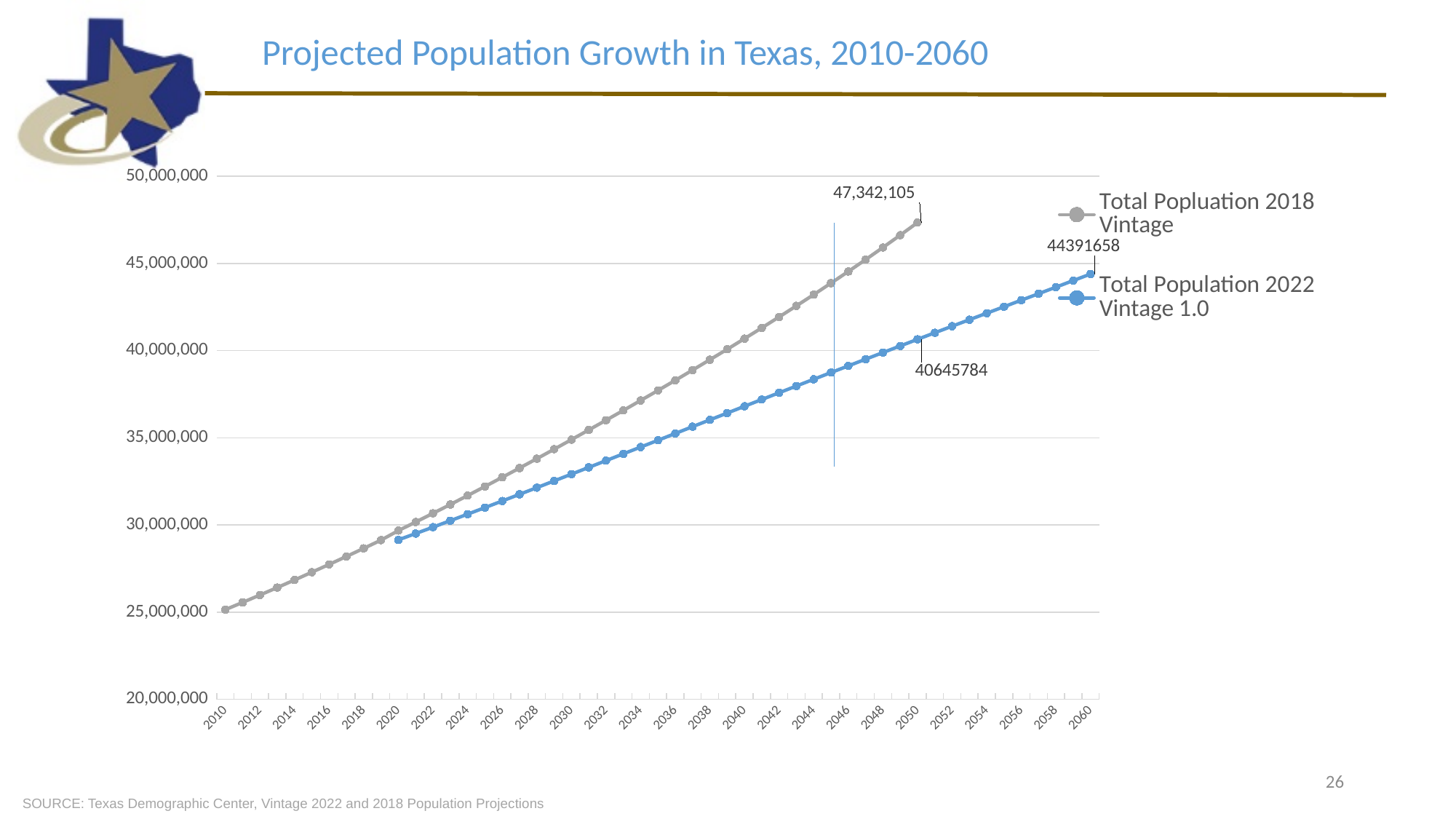
In 2050, what is the difference between the 2018 Vintage projection and the 2022 Vintage 1.0 projection? 6,696,321 What is the value of the Total Population 2022 Vintage 1.0 series in 2060? 44391658 Is the value for the Total Popluation 2018 Vintage series in 2036 greater or less than 35,000,000? greater Do the projected population values rise or fall as the years increase along the x axis? rise Is the value for the Total Population 2022 Vintage 1.0 series in 2040 greater or less than 35,000,000? greater How many series does the legend list? 2 What is the value of the Total Population 2022 Vintage 1.0 series in 2050? 40645784 What is the value of the Total Popluation 2018 Vintage series in 2050? 47,342,105 Is the value for the Total Popluation 2018 Vintage series in 2010 greater or less than 30,000,000? less What colour is the line for the Total Population 2022 Vintage 1.0 series? blue In 2050, which series has the higher projected population, the 2018 Vintage or the 2022 Vintage 1.0? Total Popluation 2018 Vintage What kind of chart is shown on the slide? line chart